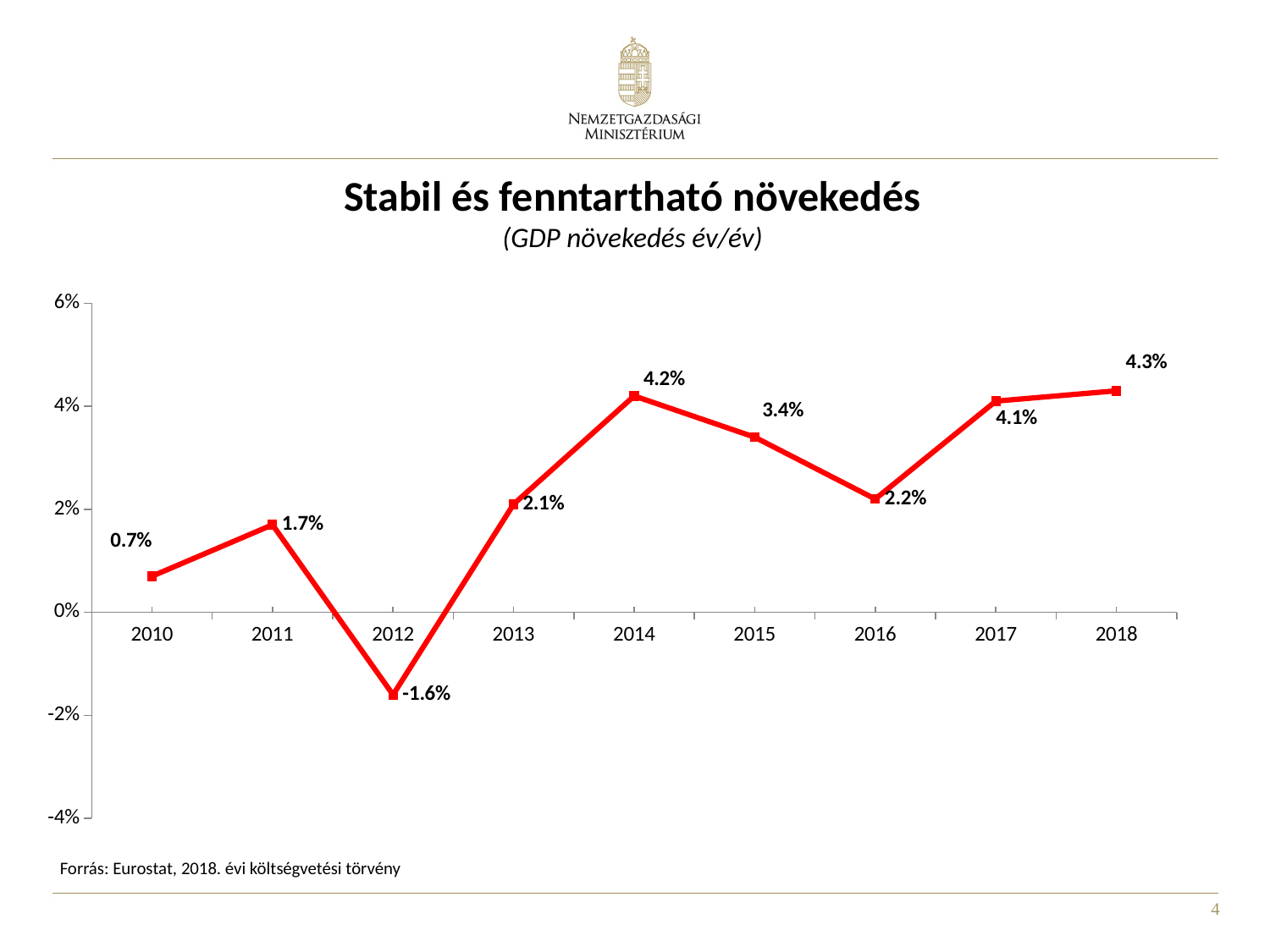
Is the value for 2017 greater or less than 2%? greater Do the values rise or fall from 2016 to 2018? rise Which year has the larger GDP growth value, 2015 or 2016? 2015 Which year has the lowest GDP growth value? 2012 What is the title of the chart? Stabil és fenntartható növekedés What is the GDP growth value for 2016? 2.2% What is the GDP growth value for 2012? -1.6% What is the difference between the GDP growth values for 2018 and 2010? 3.6% Which year has the highest GDP growth value? 2018 What kind of chart is shown on the slide? line chart What is the GDP growth value for 2014? 4.2% How many years are plotted on the chart? 9